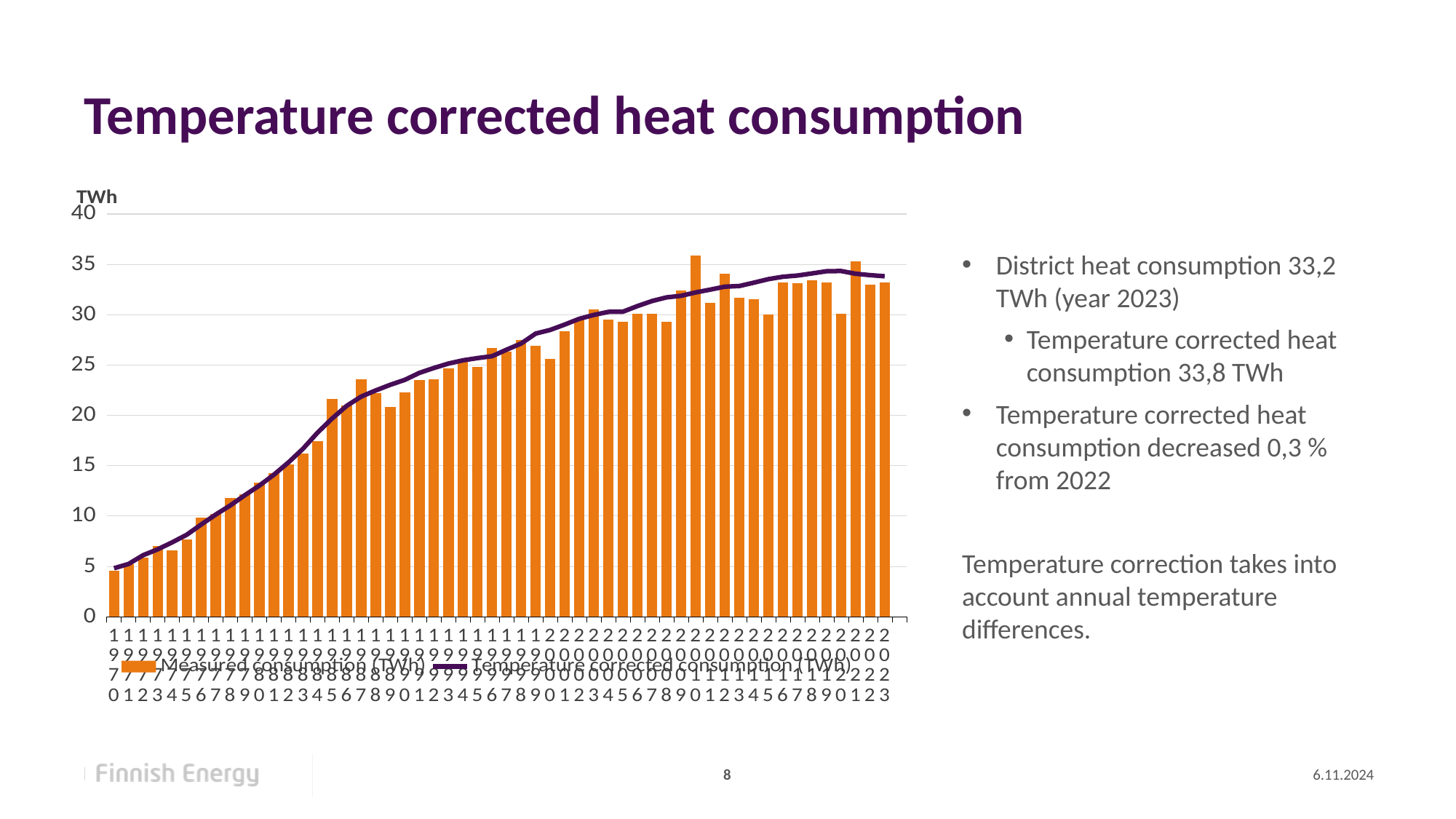
Is the measured consumption for 2000 greater or less than 25 TWh? greater Is the measured consumption for 2020 greater or less than 35 TWh? less Which year has the larger measured consumption, 2010 or 2011? 2010 What kind of chart is shown on the slide? bar and line chart Does the temperature corrected consumption line generally rise or fall from 1970 to 2023? rise How many years (bars) are plotted on the x axis? 54 Which year has the larger measured consumption, 2021 or 2022? 2021 Which year has the highest measured consumption bar? 2010 What unit is shown on the y axis of the chart? TWh Is the measured consumption for 1980 greater or less than 10 TWh? greater Which year has the lowest measured consumption bar? 1970 How many series does the legend list? 2